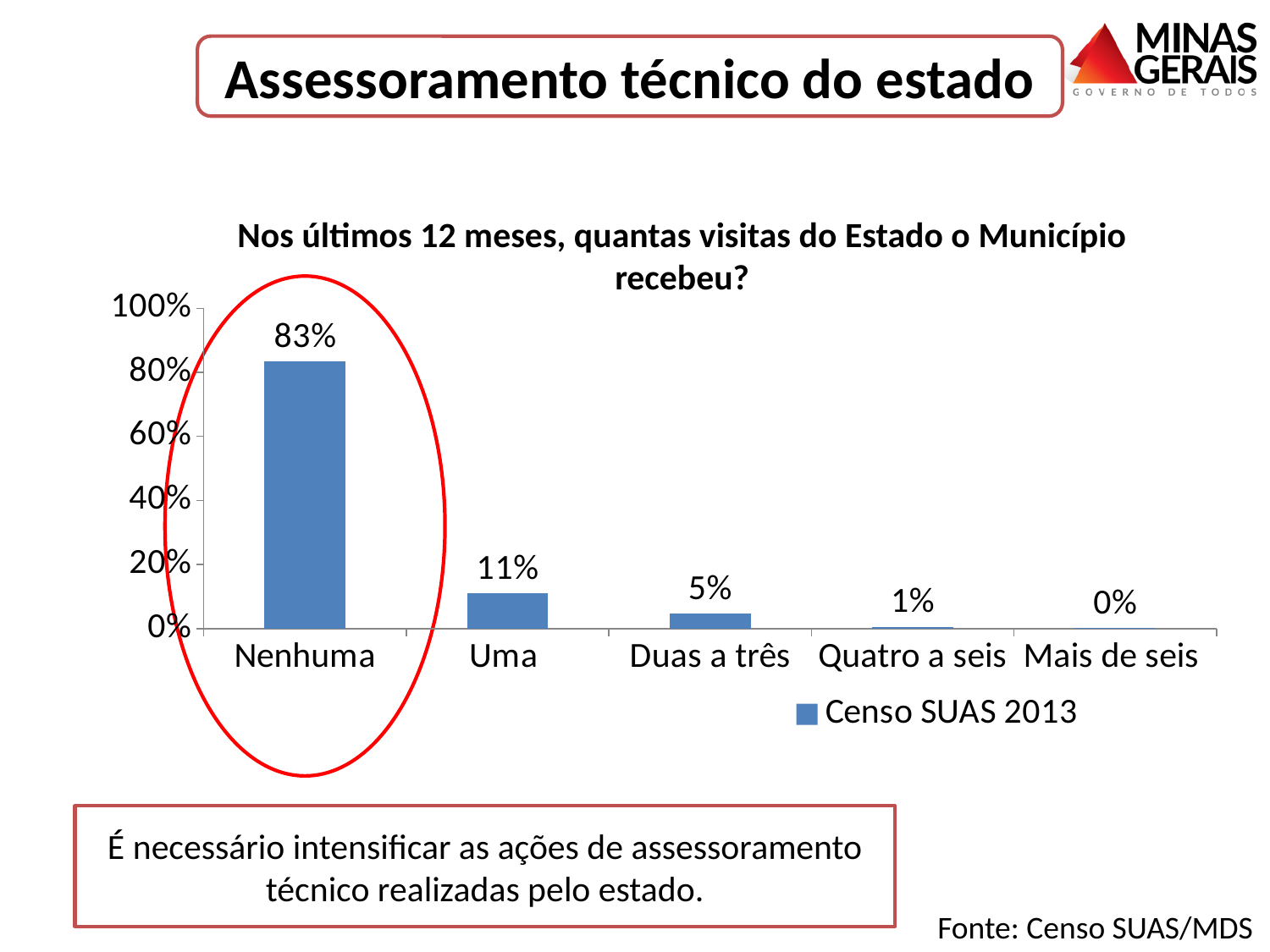
Which is larger, the value for Uma or the value for Duas a três? Uma Which category has the lowest value? Mais de seis What series does the legend list? Censo SUAS 2013 What is the value for Quatro a seis? 1% Which category has the highest value? Nenhuma What is the value for Duas a três? 5% What is the value for Uma? 11% Is the value for Nenhuma greater or less than 80%? greater What kind of chart is shown on the slide? bar chart What is the difference between the values for Nenhuma and Uma? 72% How many categories are shown on the x axis? 5 What is the value for Nenhuma? 83%